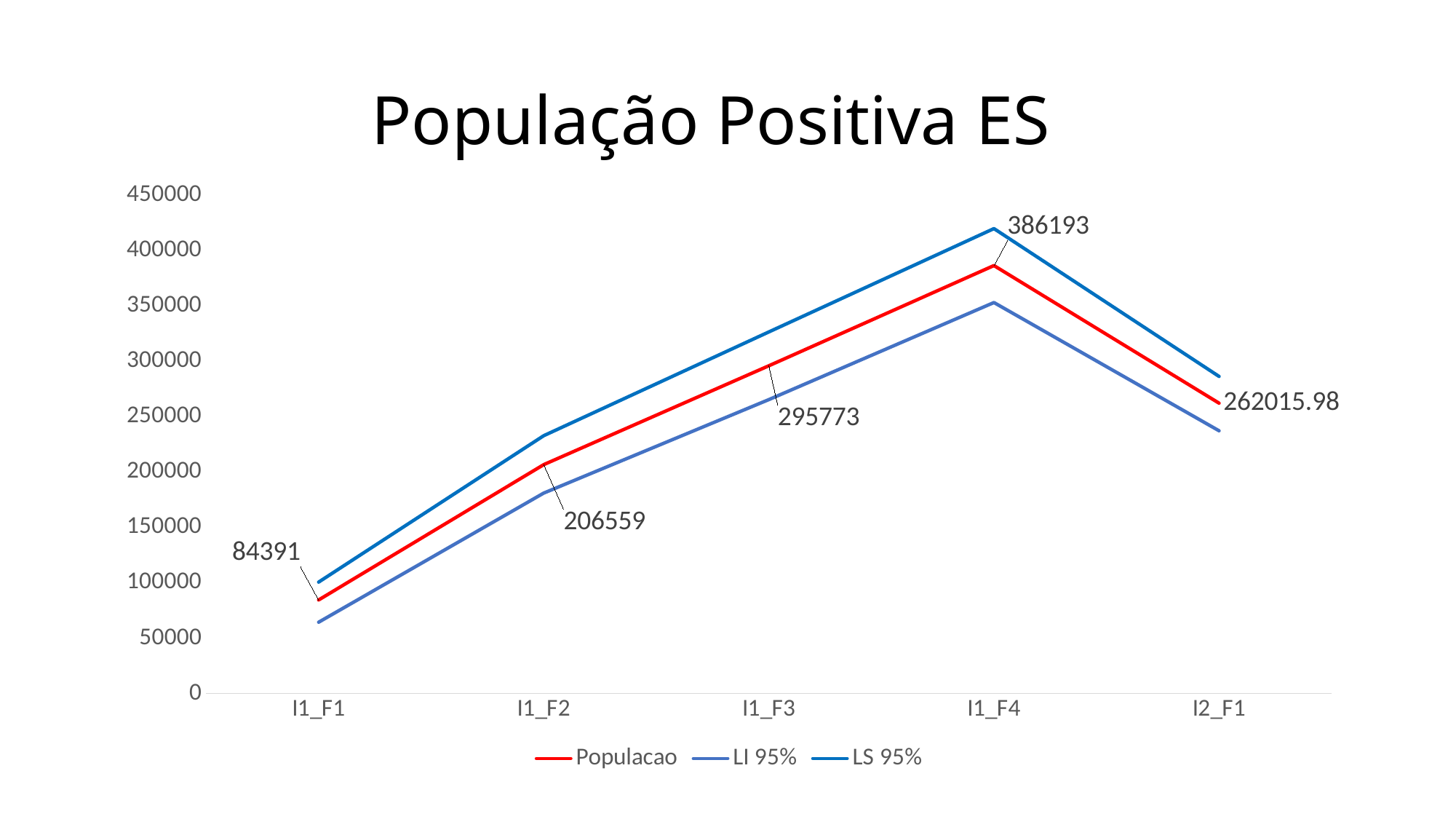
What is the Populacao value for I2_F1? 262015.98 How many categories are shown on the x axis? 5 What is the Populacao value for I1_F3? 295773 At which category does the Populacao series reach its highest value? I1_F4 What is the Populacao value for I1_F1? 84391 At which category is the Populacao series lowest? I1_F1 What kind of chart is shown on the slide? line chart Is the LS 95% value for I1_F4 greater or less than 400000? greater How many series does the legend list? 3 What is the difference between the Populacao values for I1_F4 and I1_F3? 90420 What is the Populacao value for I1_F4? 386193 What is the Populacao value for I1_F2? 206559